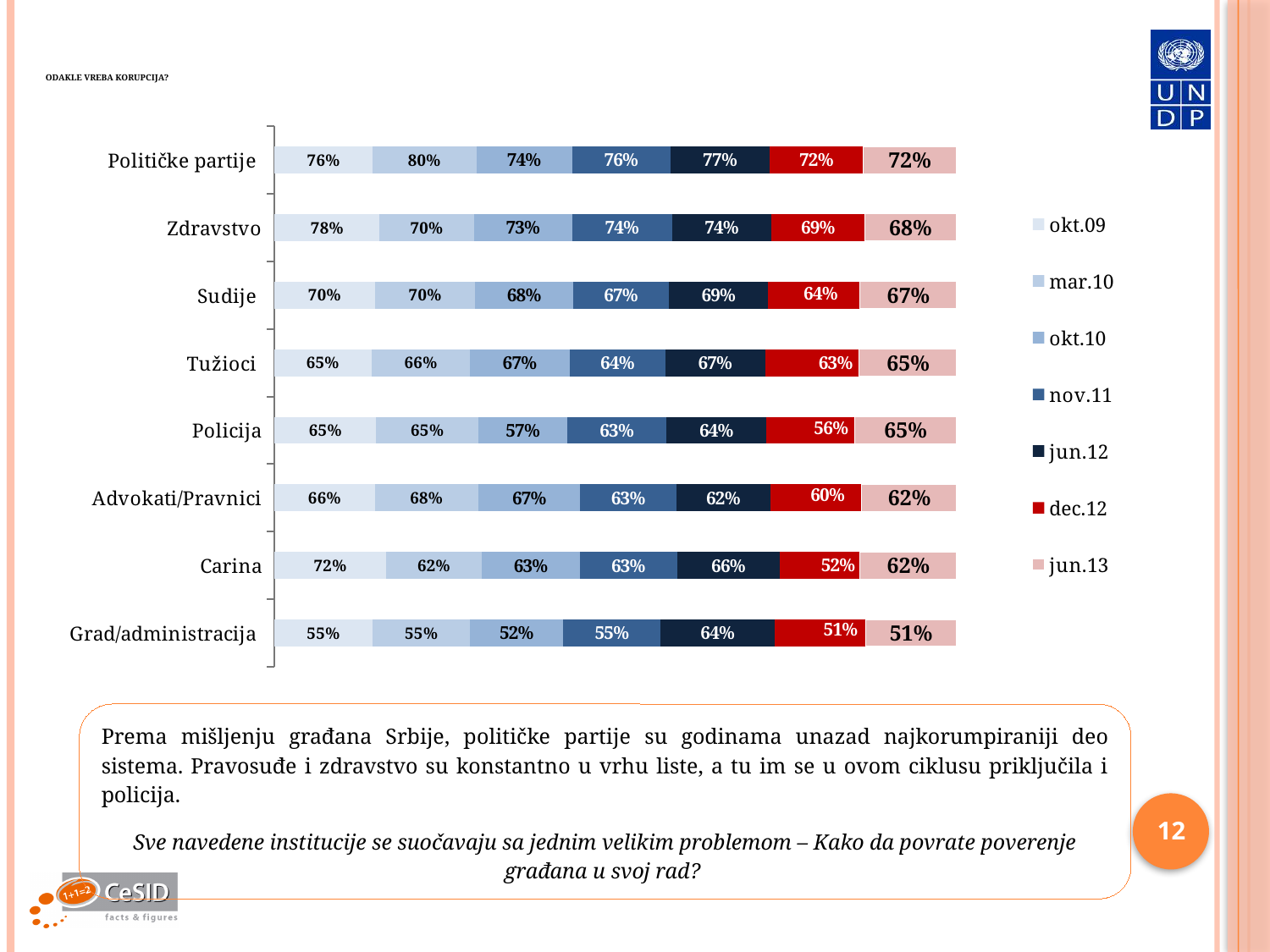
What is the difference between the okt.09 and dec.12 values for Carina? 20% How many series does the legend list? 7 Which is larger in the nov.11 series: Zdravstvo or Sudije? Zdravstvo Which series is shown in red in the legend? dec.12 What is the value for Političke partije in the mar.10 series? 80% What is the value for Policija in the okt.10 series? 57% How many categories are shown on the chart? 8 What is the value for Grad/administracija in the jun.12 series? 64% Which category has the highest value in the jun.13 series? Političke partije What is the value for Carina in the dec.12 series? 52% What kind of chart is shown on the slide? Stacked bar chart Which category has the lowest value in the okt.09 series? Grad/administracija